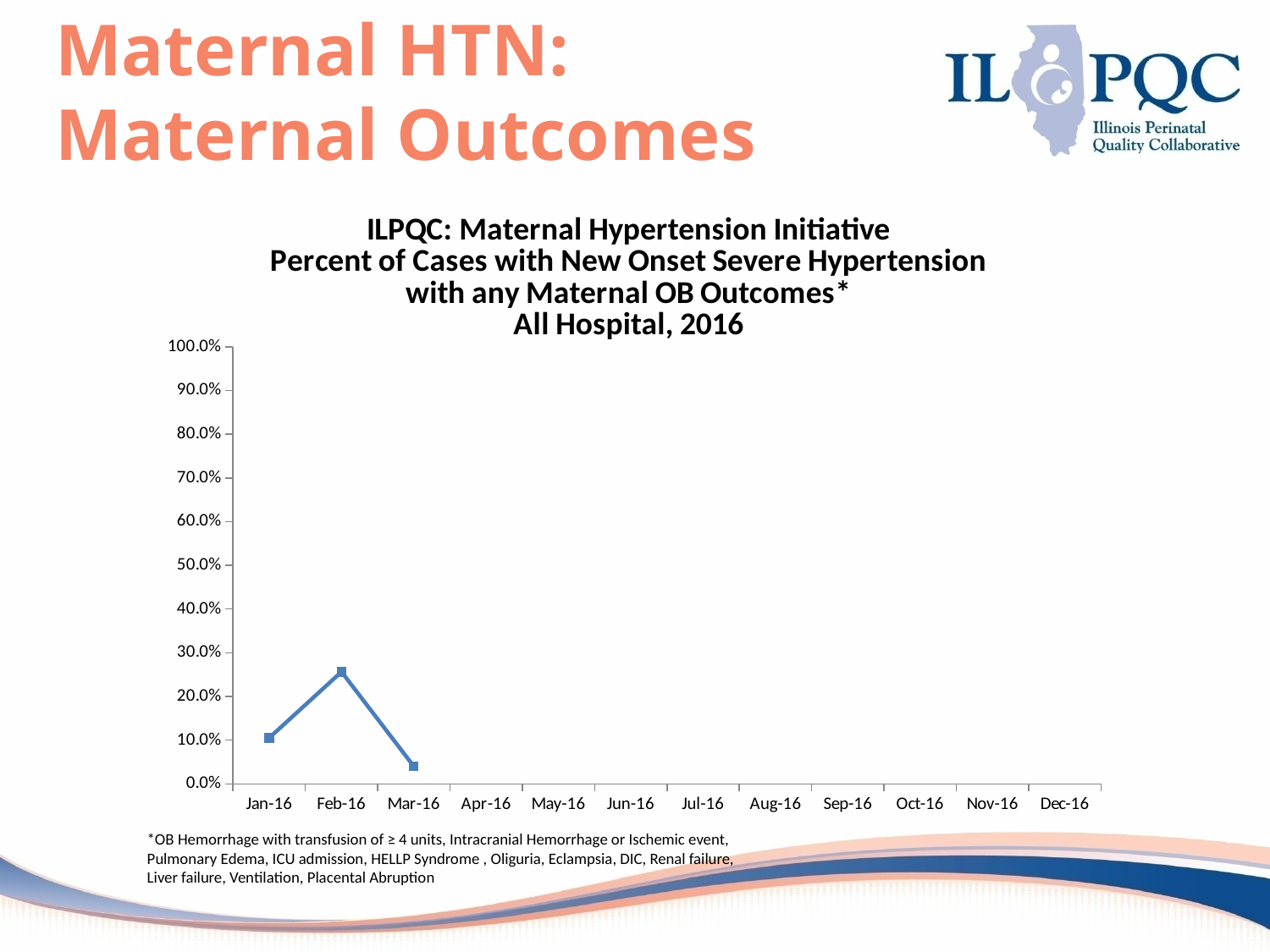
What kind of chart is shown on the slide? line chart How many months have a plotted data point on the line? 3 Which month has the highest plotted value? Feb-16 Which month has the lowest plotted value? Mar-16 Is the value for Mar-16 greater or less than 10.0%? less Which is larger, the value for Feb-16 or the value for Jan-16? Feb-16 How many month labels are shown on the x axis? 12 Does the line rise or fall from Feb-16 to Mar-16? fall Is the value for Feb-16 greater or less than 20.0%? greater Is the value for Jan-16 greater or less than 20.0%? less Which is larger, the value for Jan-16 or the value for Mar-16? Jan-16